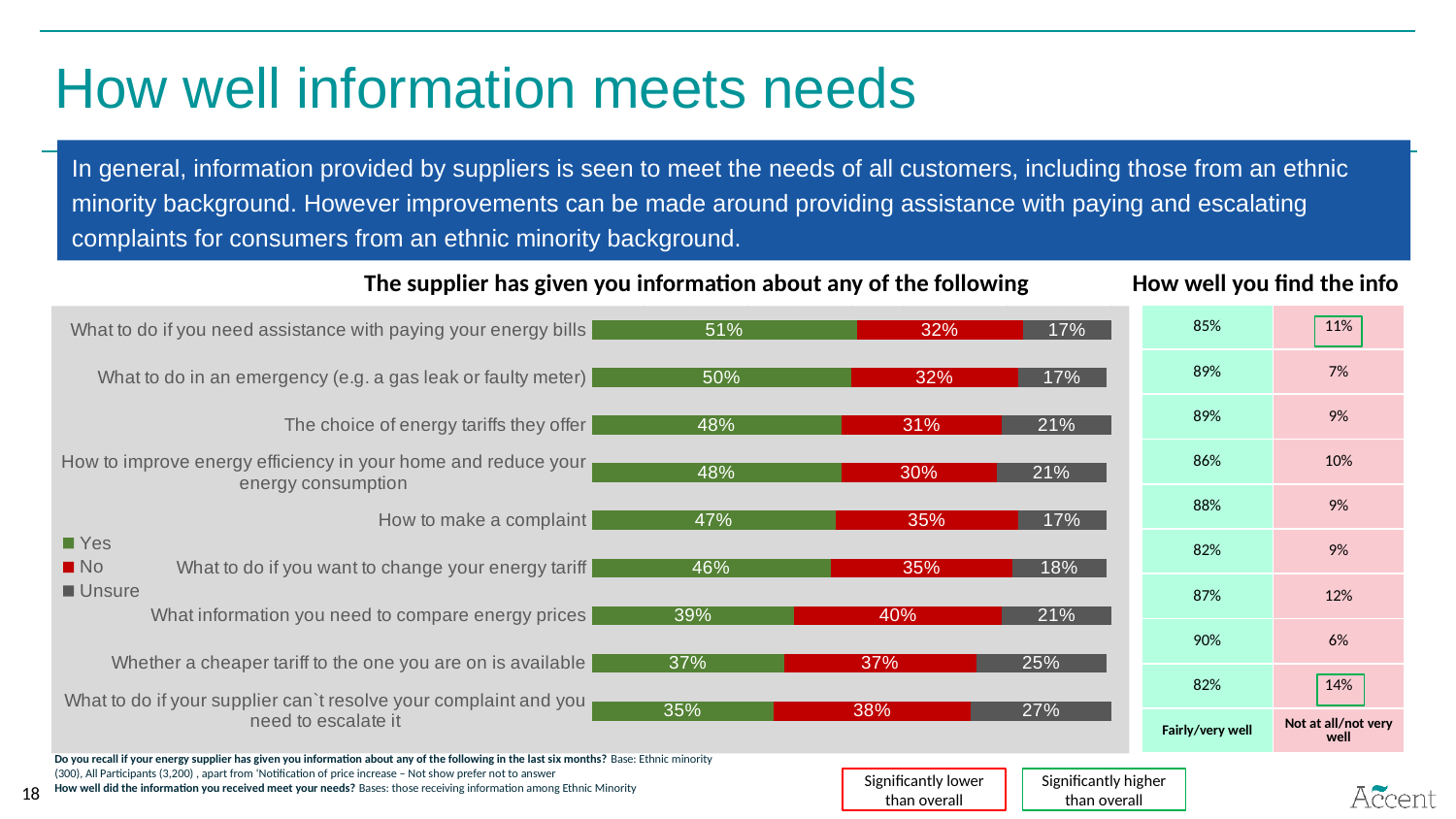
In the stacked bar chart, what is the No value for 'What information you need to compare energy prices'? 40% How many categories are shown in the stacked bar chart? 9 What are the legend entries of the stacked bar chart? Yes, No, Unsure In the stacked bar chart, for 'What information you need to compare energy prices', is the Yes value or the No value larger? No In the stacked bar chart, what is the difference between the Yes value for 'What to do if you need assistance with paying your energy bills' and the Yes value for 'What to do if your supplier can`t resolve your complaint and you need to escalate it'? 16 percentage points In the stacked bar chart, which category has the highest Unsure value? What to do if your supplier can`t resolve your complaint and you need to escalate it In the stacked bar chart, which category has the lowest Yes value? What to do if your supplier can`t resolve your complaint and you need to escalate it In the chart 'The supplier has given you information about any of the following', what percentage answered Yes for 'What to do in an emergency (e.g. a gas leak or faulty meter)'? 50% What type of chart is used to show 'The supplier has given you information about any of the following'? Stacked bar chart In the stacked bar chart, which category has the highest Yes value? What to do if you need assistance with paying your energy bills In the stacked bar chart, what is the Unsure value for 'What to do if your supplier can`t resolve your complaint and you need to escalate it'? 27% How many series does the legend of the stacked bar chart list? 3